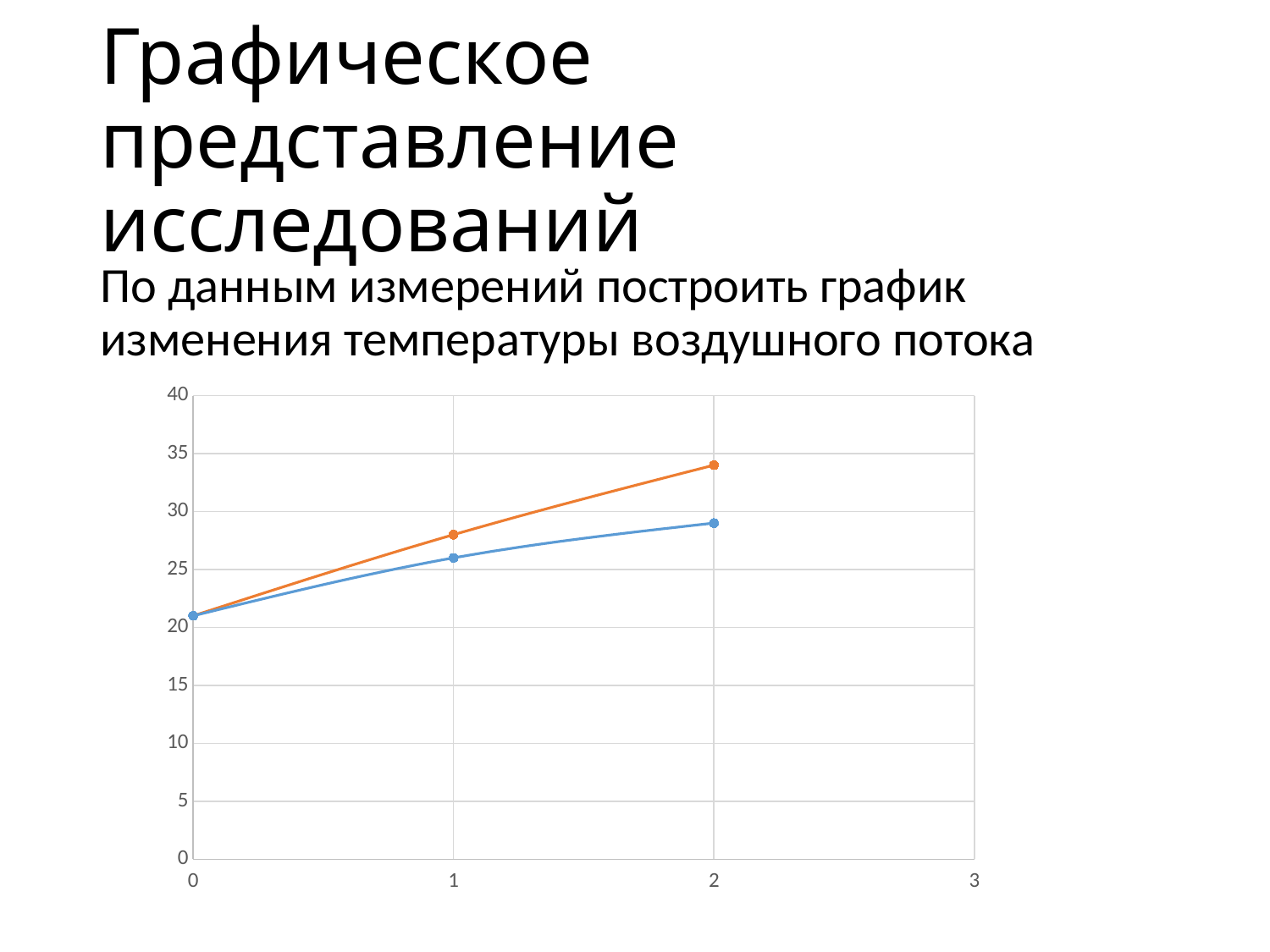
How many lines are plotted on the chart? 2 Do the values of the orange line rise or fall as x increases from 0 to 2? rise How many data points does each line have? 3 At x = 1, which line has the higher value, the orange line or the blue line? orange line At x = 2, which line has the higher value, the orange line or the blue line? orange line What kind of chart is shown on the slide? line chart Is the value of the orange line at x = 1 greater or less than 25? greater Is the value of the blue line at x = 2 greater or less than 25? greater Is the value of the blue line at x = 1 greater or less than 30? less What is the maximum value shown on the vertical axis? 40 Do the values of the blue line rise or fall as x increases from 0 to 2? rise